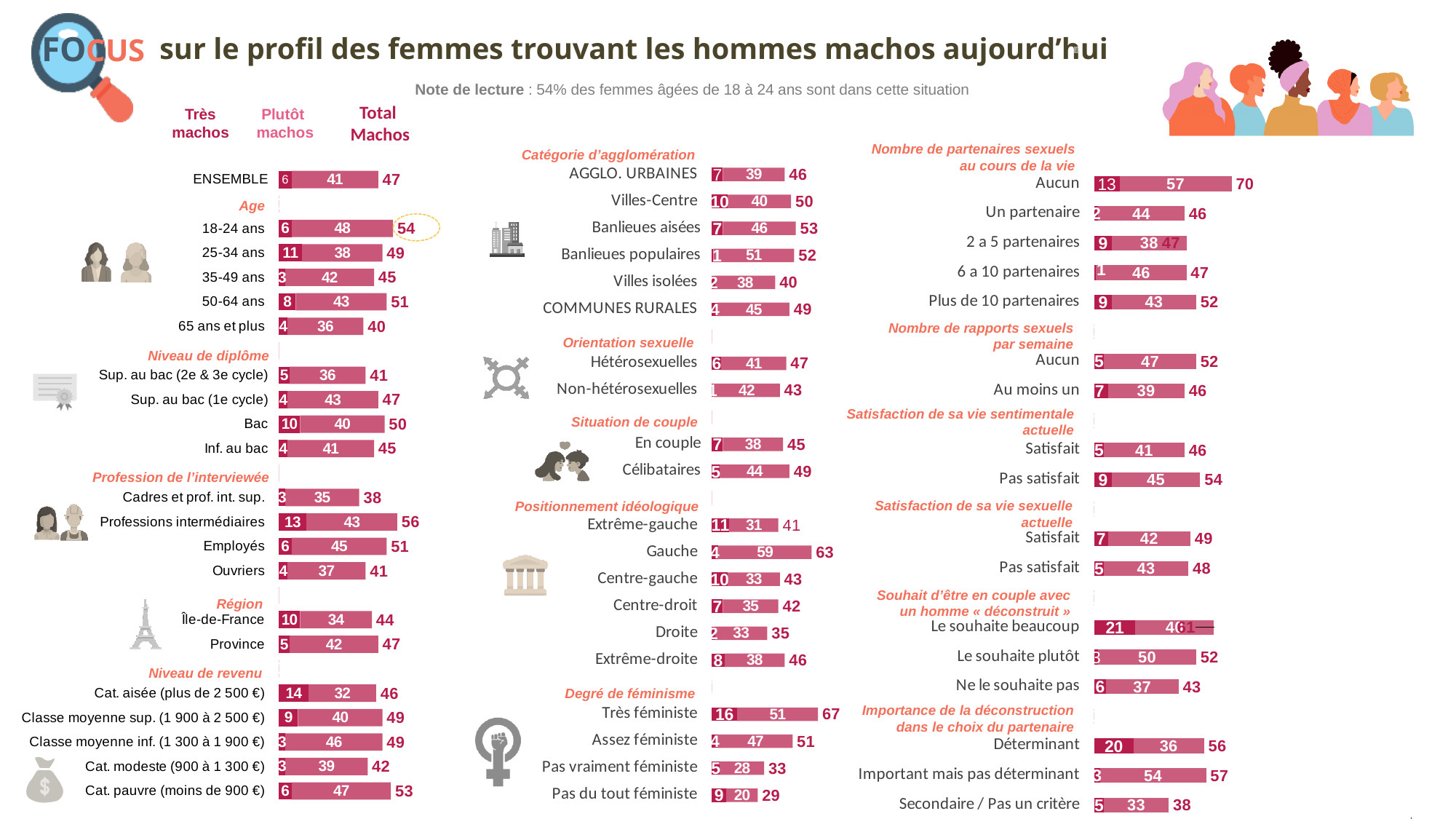
In the 'Importance de la déconstruction dans le choix du partenaire' chart, what is the 'Très machos' value for Déterminant? 20 In the 'Positionnement idéologique' chart, which category has the highest Total Machos value? Gauche In the 'Age' chart, what is the Total Machos value for 18-24 ans? 54 In the 'Région' chart, which has the larger Total Machos value, Île-de-France or Province? Province In the 'Niveau de revenu' chart, what is the Total Machos value for Cat. pauvre (moins de 900 €)? 53 In the 'Nombre de partenaires sexuels au cours de la vie' chart, what is the Total Machos value for Aucun? 70 In the 'Profession de l'interviewée' chart, what is the difference in Total Machos between Professions intermédiaires and Cadres et prof. int. sup.? 18 What kind of chart is used throughout this slide? Bar chart In the 'Degré de féminisme' chart, which category has the lowest Total Machos value? Pas du tout féministe In the 'Niveau de diplôme' chart, what is the 'Plutôt machos' value for Bac? 40 How many categories are shown in the 'Catégorie d'agglomération' chart? 6 How many series are shown in the column headers at the top left (Très machos, Plutôt machos, Total Machos)? 3